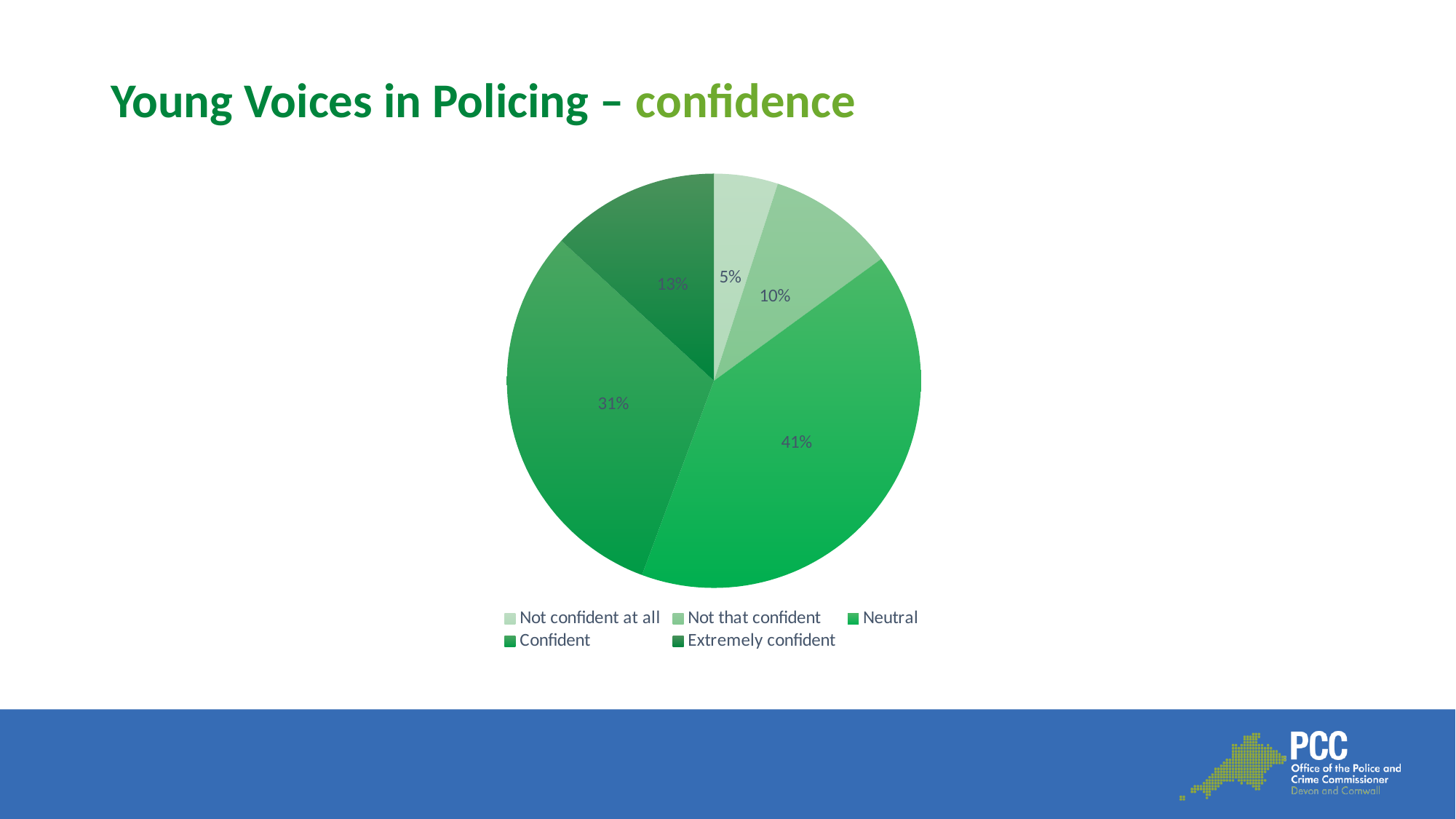
Which category has the smallest share of the pie? Not confident at all Which category has the largest share of the pie? Neutral What percentage of respondents were Neutral? 41% What percentage of respondents were Not that confident? 10% What kind of chart is shown on the slide? Pie chart What is the title of the slide? Young Voices in Policing – confidence What percentage of respondents were Extremely confident? 13% What percentage of respondents were Not confident at all? 5% What percentage of respondents were Confident? 31% What is the difference in percentage points between Neutral and Confident? 10 How many categories does the legend list? 5 Which is larger, the share for Extremely confident or the share for Not that confident? Extremely confident